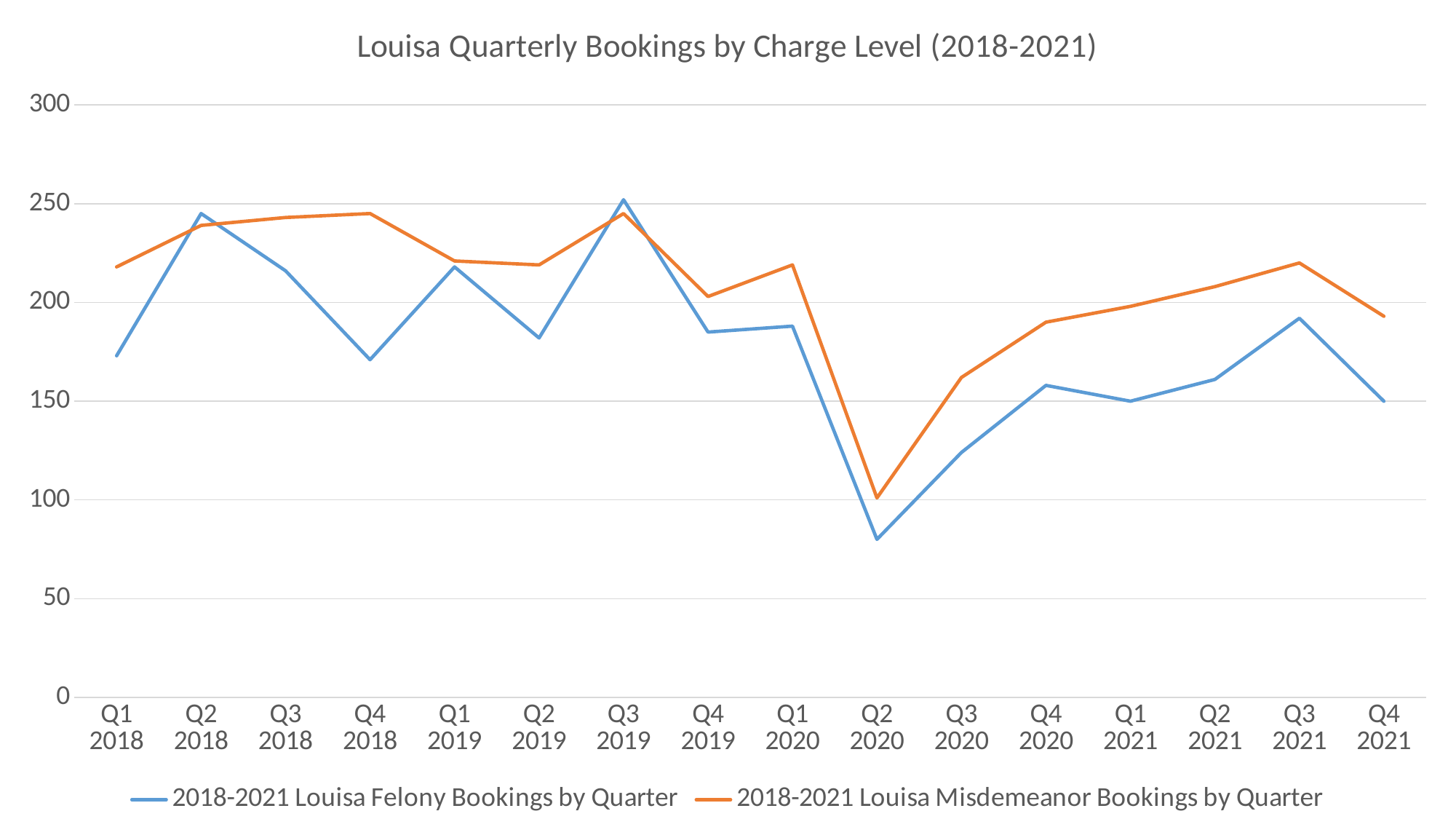
What kind of chart is shown on the slide? Line chart Which colour is used for the 2018-2021 Louisa Misdemeanor Bookings by Quarter line? Orange In Q4 2019, which series has the larger value: Felony Bookings or Misdemeanor Bookings? 2018-2021 Louisa Misdemeanor Bookings by Quarter In which quarter is the value for 2018-2021 Louisa Felony Bookings by Quarter lowest? Q2 2020 Is the value for 2018-2021 Louisa Felony Bookings by Quarter in Q2 2020 greater or less than 100? less What is the title of the chart? Louisa Quarterly Bookings by Charge Level (2018-2021) In which quarter is the value for 2018-2021 Louisa Misdemeanor Bookings by Quarter lowest? Q2 2020 How many series does the legend list? 2 How many quarters are plotted along the x axis? 16 Is the value for 2018-2021 Louisa Felony Bookings by Quarter in Q3 2020 greater or less than 150? less Is the value for 2018-2021 Louisa Misdemeanor Bookings by Quarter in Q1 2018 greater or less than 200? greater Does the value for 2018-2021 Louisa Misdemeanor Bookings by Quarter rise or fall from Q2 2020 to Q3 2021? Rise